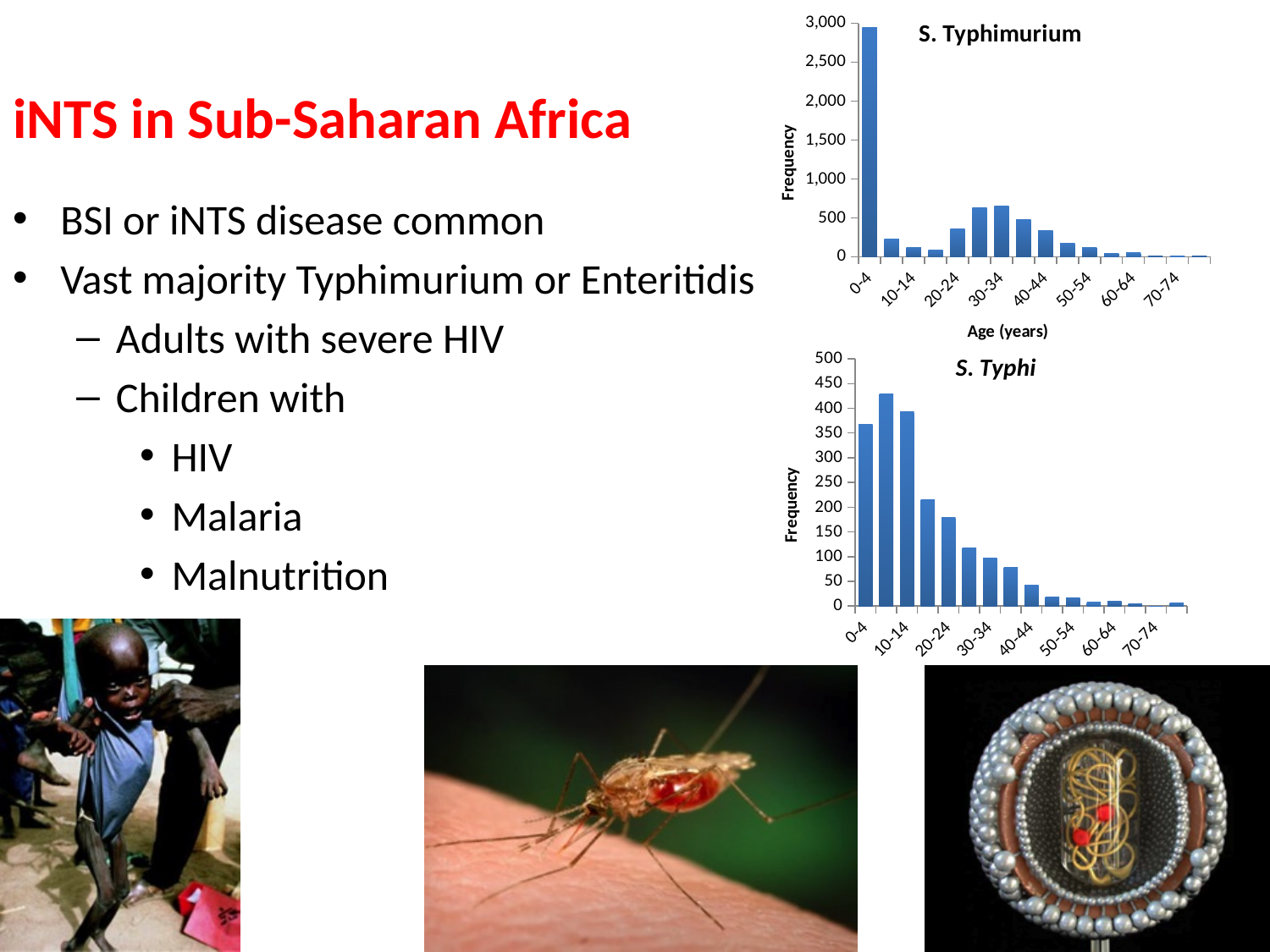
What kind of chart is the S. Typhimurium chart? bar chart In the S. Typhimurium chart, is the value for the 0-4 age group greater or less than 2,500? greater In the S. Typhimurium chart, is the value for the 30-34 age group greater or less than 1,000? less In the S. Typhimurium chart, which age group has the larger frequency, 0-4 or 30-34? 0-4 In the S. Typhi chart, is the value for the 40-44 age group greater or less than 150? less In the S. Typhi chart, which age group has the larger frequency, 10-14 or 40-44? 10-14 In the S. Typhi chart, do the values generally rise or fall from the 10-14 age group to the 70-74 age group? fall What is the x-axis label of the S. Typhimurium chart? Age (years) In the S. Typhimurium chart, which age group has the highest frequency? 0-4 What is the label on the y-axis of the S. Typhi chart? Frequency